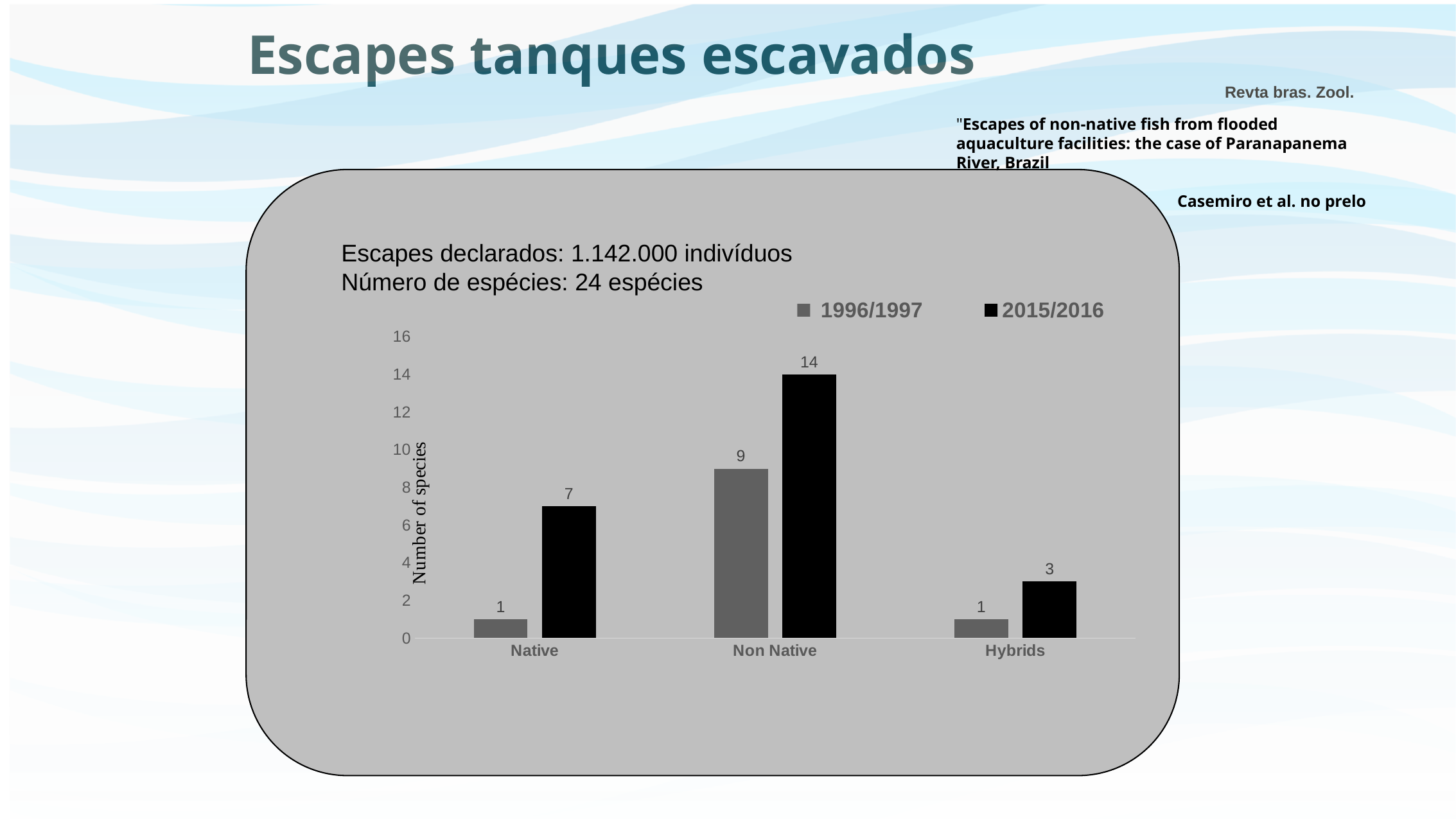
Which category has the highest value in the 2015/2016 series? Non Native What is the difference between the 2015/2016 and 1996/1997 values for Non Native? 5 What is the label of the vertical axis? Number of species What is the value for Non Native in the 2015/2016 series? 14 What kind of chart is shown on the slide? Bar chart What is the value for Native in the 1996/1997 series? 1 Which is larger: the 1996/1997 value for Non Native or the 2015/2016 value for Native? 1996/1997 value for Non Native How many categories are shown on the x axis? 3 Which category has the lowest value in the 2015/2016 series? Hybrids How many series does the legend list? 2 What is the value for Hybrids in the 2015/2016 series? 3 What is the difference between the 2015/2016 and 1996/1997 values for Native? 6